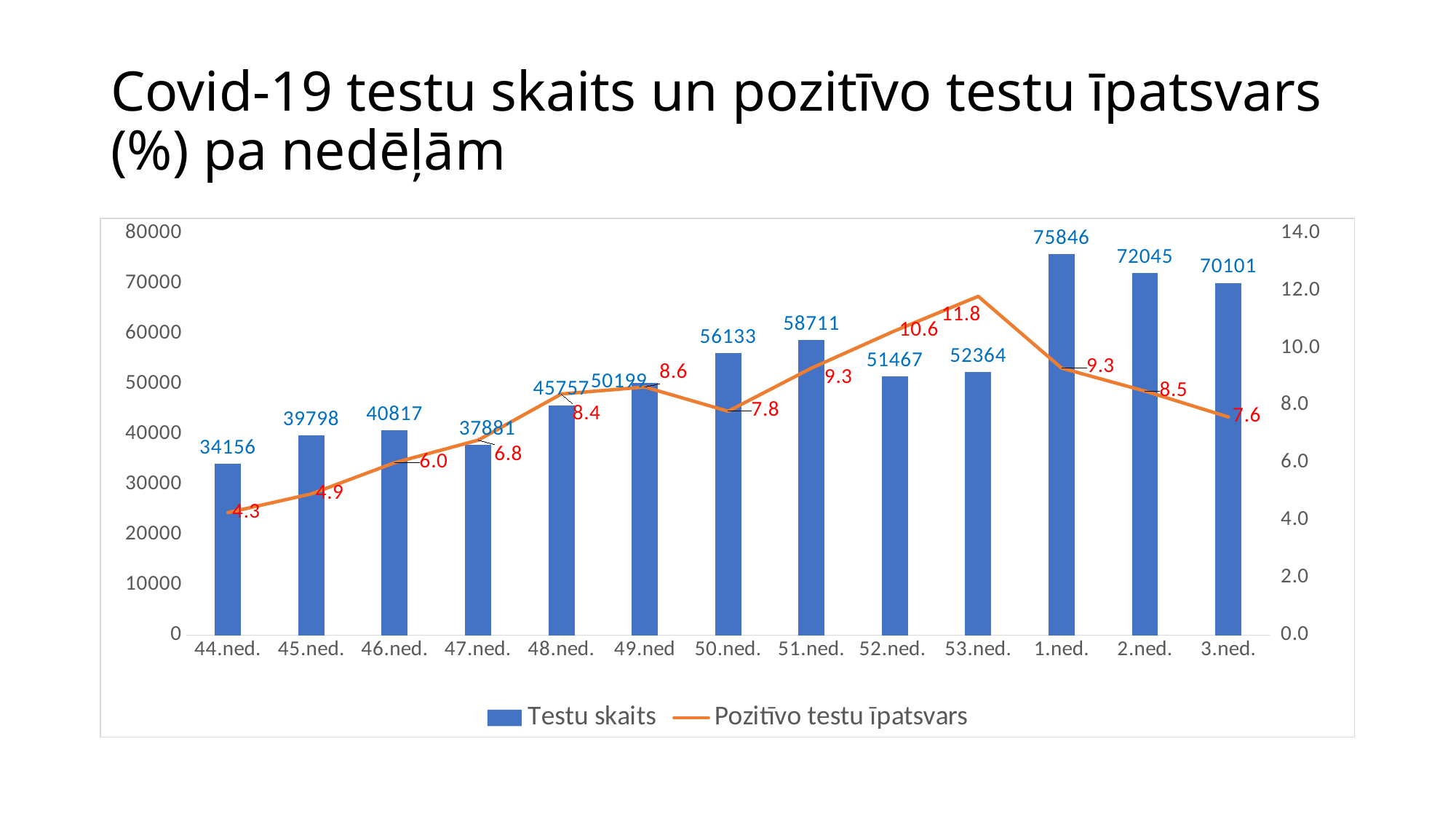
What is the difference in the share of positive tests between 53.ned. and 44.ned.? 7.5 What is the difference in the number of tests between 1.ned. and 2.ned.? 3801 Does the share of positive tests rise or fall from 53.ned. to 3.ned.? Fall How many series does the legend list? 2 What kind of chart is used for the Testu skaits series? Bar chart What is the share of positive tests (Pozitīvo testu īpatsvars) for 53.ned.? 11.8 Which week has the highest number of tests (Testu skaits)? 1.ned. How many weeks (categories) are shown on the x axis? 13 Which week has the lowest share of positive tests (Pozitīvo testu īpatsvars)? 44.ned. What is the number of tests (Testu skaits) for 44.ned.? 34156 What is the number of tests (Testu skaits) for 1.ned.? 75846 Which week has more tests, 50.ned. or 52.ned.? 50.ned.